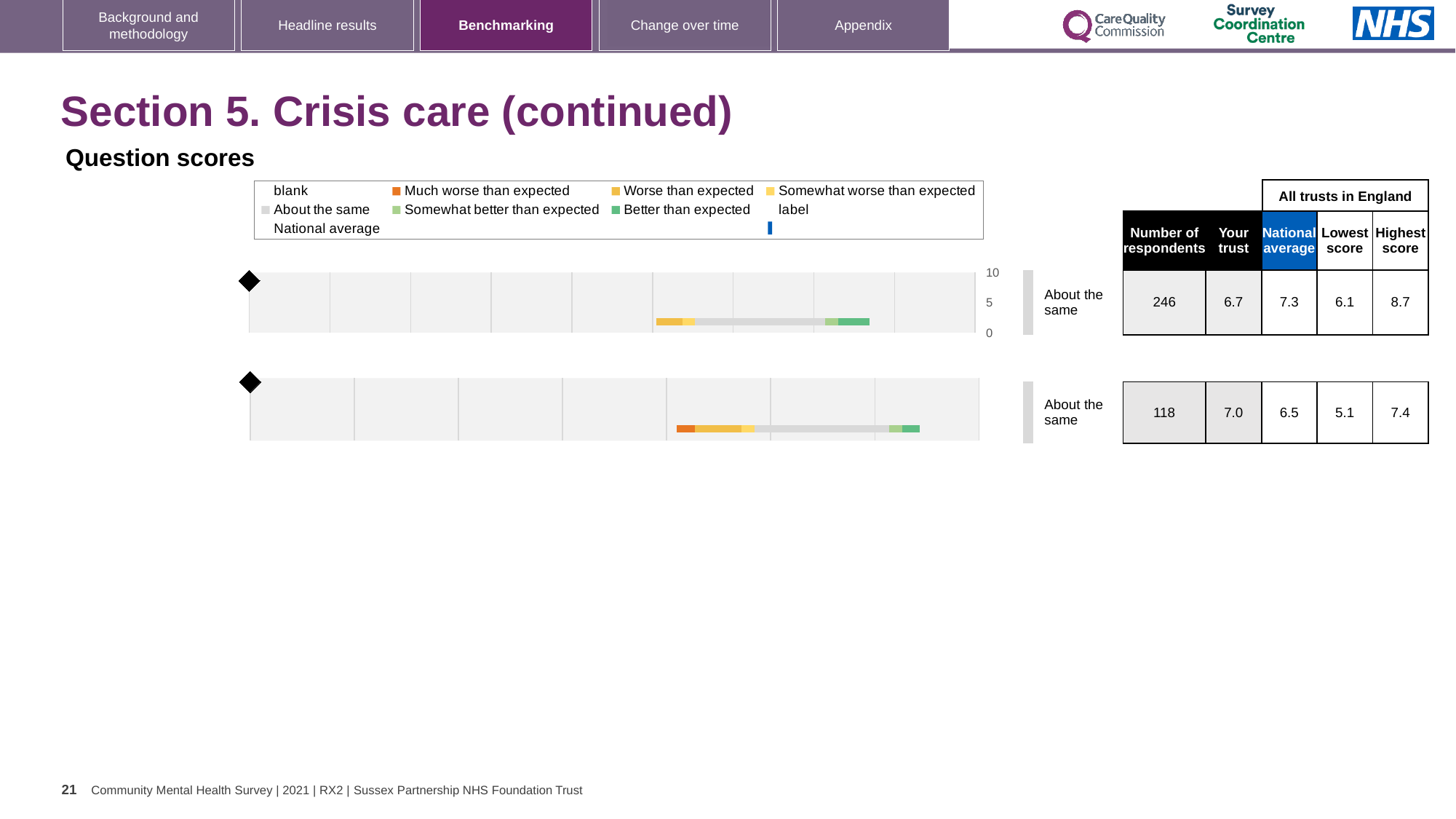
For the top chart, which is larger: the 'Your trust' score or the national average? National average For the bottom chart, what is the number of respondents? 118 For the bottom chart, what is the difference between the 'Your trust' score (7.0) and the national average (6.5)? 0.5 In the legend, which colour represents 'Much worse than expected'? Orange For the top chart, what is the number of respondents shown in the table? 246 How many question score charts are shown on the slide? 2 For the bottom chart, which is larger: the 'Your trust' score or the national average? Your trust For the top chart, what is the national average score? 7.3 For the top chart, what is the difference between the highest score (8.7) and the lowest score (6.1)? 2.6 For the bottom chart, what is the highest score among all trusts in England? 7.4 For the top chart, what is the 'Your trust' score? 6.7 What kind of chart is used to show the question scores on this slide? bar chart